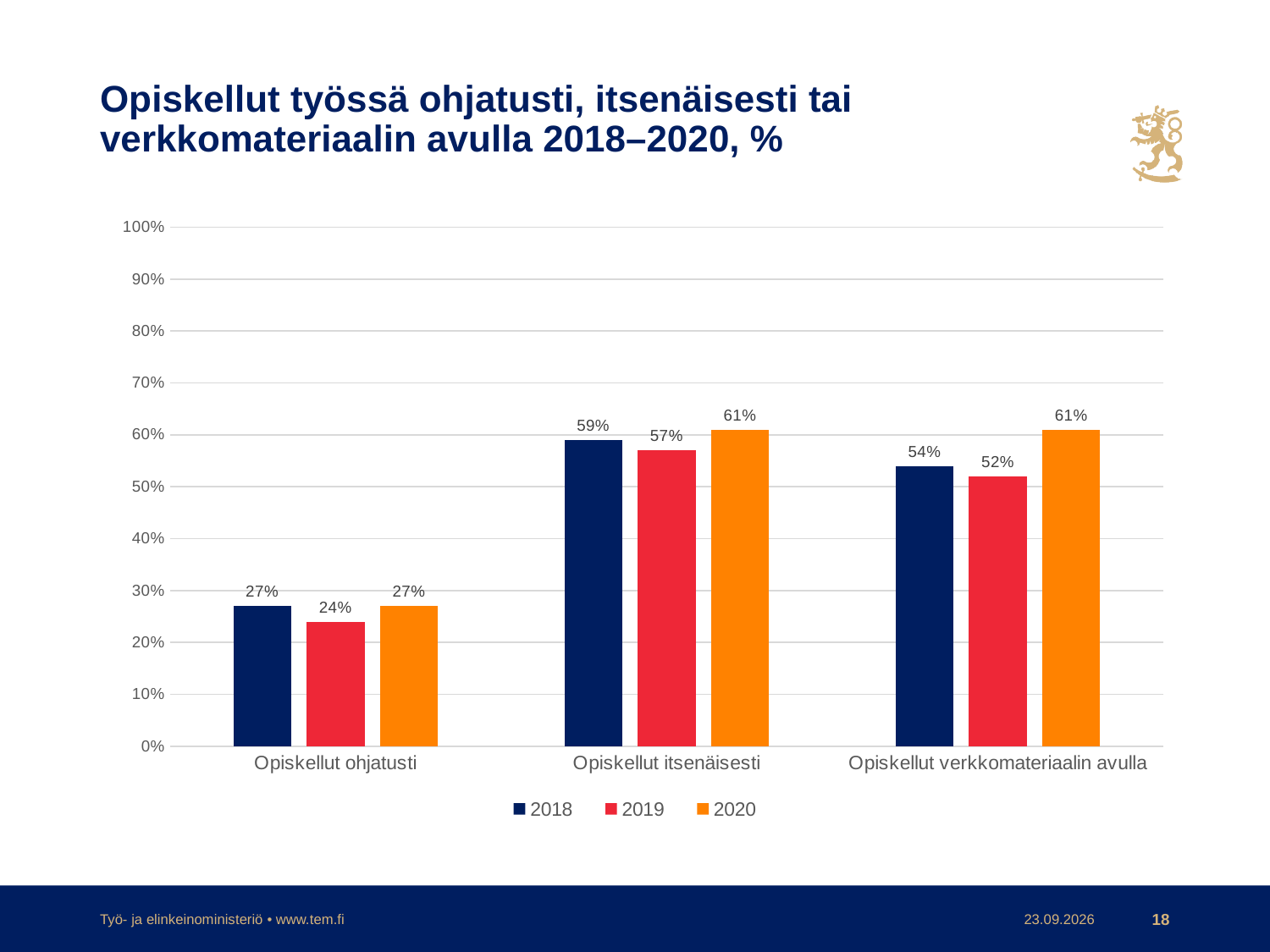
How many series does the legend list? 3 What is the value for 2018 in the Opiskellut verkkomateriaalin avulla category? 54% What is the value for 2020 in the Opiskellut itsenäisesti category? 61% What is the difference between the 2020 and 2019 values in the Opiskellut verkkomateriaalin avulla category? 9% How many categories are shown on the x axis? 3 Which year has the highest value in the Opiskellut verkkomateriaalin avulla category? 2020 Which colour represents the 2020 series in the legend? Orange Which is larger: the 2018 value for Opiskellut itsenäisesti or the 2018 value for Opiskellut verkkomateriaalin avulla? Opiskellut itsenäisesti What is the value for 2019 in the Opiskellut ohjatusti category? 24% Which category has the lowest value for 2018? Opiskellut ohjatusti What kind of chart is shown on the slide? Bar chart Is the 2019 value for Opiskellut itsenäisesti greater or less than 50%? greater